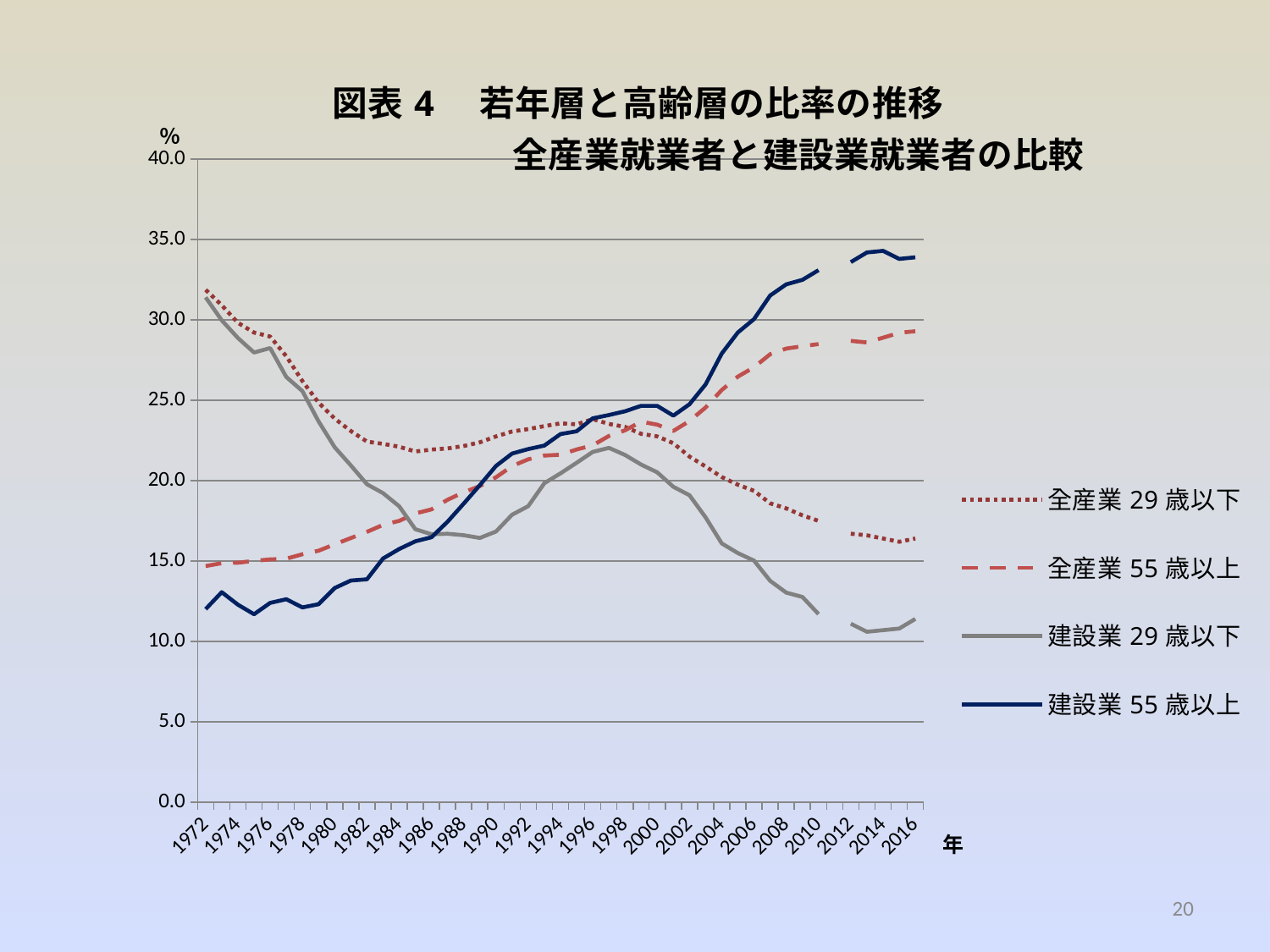
In 2016, which is higher: 建設業 55 歳以上 or 全産業 55 歳以上? 建設業 55 歳以上 Does the 建設業 29 歳以下 series rise or fall overall from 1972 to 2016? Fall How many series does the legend list? 4 What unit is shown on the vertical axis? % Which series has the highest value in 2016? 建設業 55 歳以上 Is the value for 建設業 55 歳以上 in 2016 greater or less than 30.0? greater What kind of chart is shown on the slide? Line chart Does the 建設業 55 歳以上 series rise or fall overall from 1972 to 2016? Rise Is the value for 全産業 55 歳以上 in 1972 greater or less than 20.0? less Which series has the lowest value in 2016? 建設業 29 歳以下 What is the title of the chart? 図表 4 若年層と高齢層の比率の推移 全産業就業者と建設業就業者の比較 Is the value for 建設業 29 歳以下 in 2016 greater or less than 15.0? less